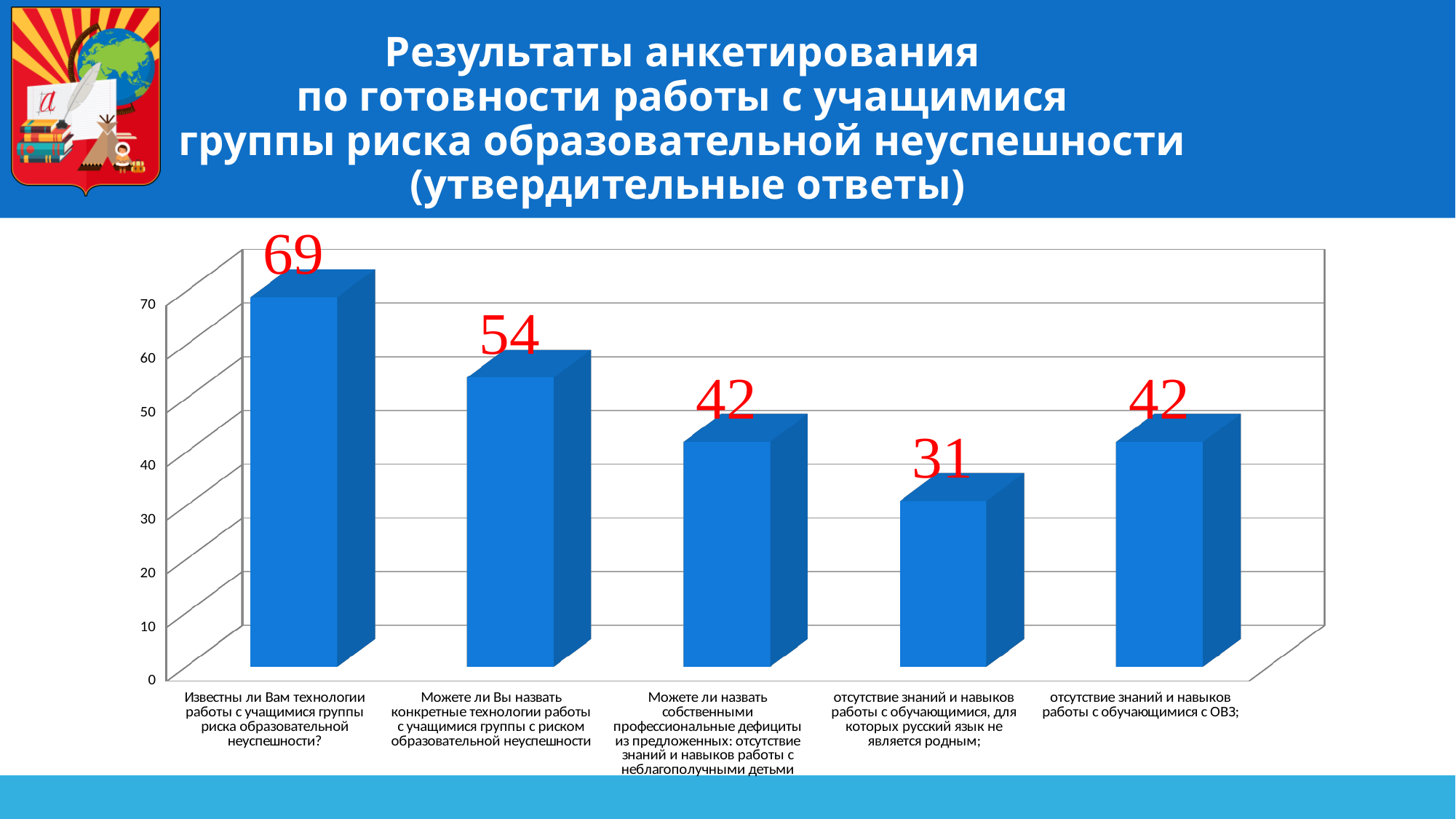
Which is larger: the value for "Можете ли Вы назвать конкретные технологии работы с учащимися группы с риском образовательной неуспешности" or the value for "отсутствие знаний и навыков работы с обучающимися с ОВЗ;"? Можете ли Вы назвать конкретные технологии работы с учащимися группы с риском образовательной неуспешности What value is shown for the category "отсутствие знаний и навыков работы с обучающимися, для которых русский язык не является родным;"? 31 How many categories are shown in the chart? 5 What value is shown for the category "отсутствие знаний и навыков работы с обучающимися с ОВЗ;"? 42 What is the difference between the value for "Известны ли Вам технологии работы с учащимися группы риска образовательной неуспешности?" and the value for "Можете ли Вы назвать конкретные технологии работы с учащимися группы с риском образовательной неуспешности"? 15 Which category has the highest value? Известны ли Вам технологии работы с учащимися группы риска образовательной неуспешности? Which category has the lowest value? отсутствие знаний и навыков работы с обучающимися, для которых русский язык не является родным; What value is shown for the category "Известны ли Вам технологии работы с учащимися группы риска образовательной неуспешности?"? 69 What kind of chart is shown on the slide? Bar chart What colour are the bars in the chart? Blue What value is shown for the category "Можете ли Вы назвать конкретные технологии работы с учащимися группы с риском образовательной неуспешности"? 54 What is the difference between the value for "отсутствие знаний и навыков работы с обучающимися с ОВЗ;" and the value for "отсутствие знаний и навыков работы с обучающимися, для которых русский язык не является родным;"? 11